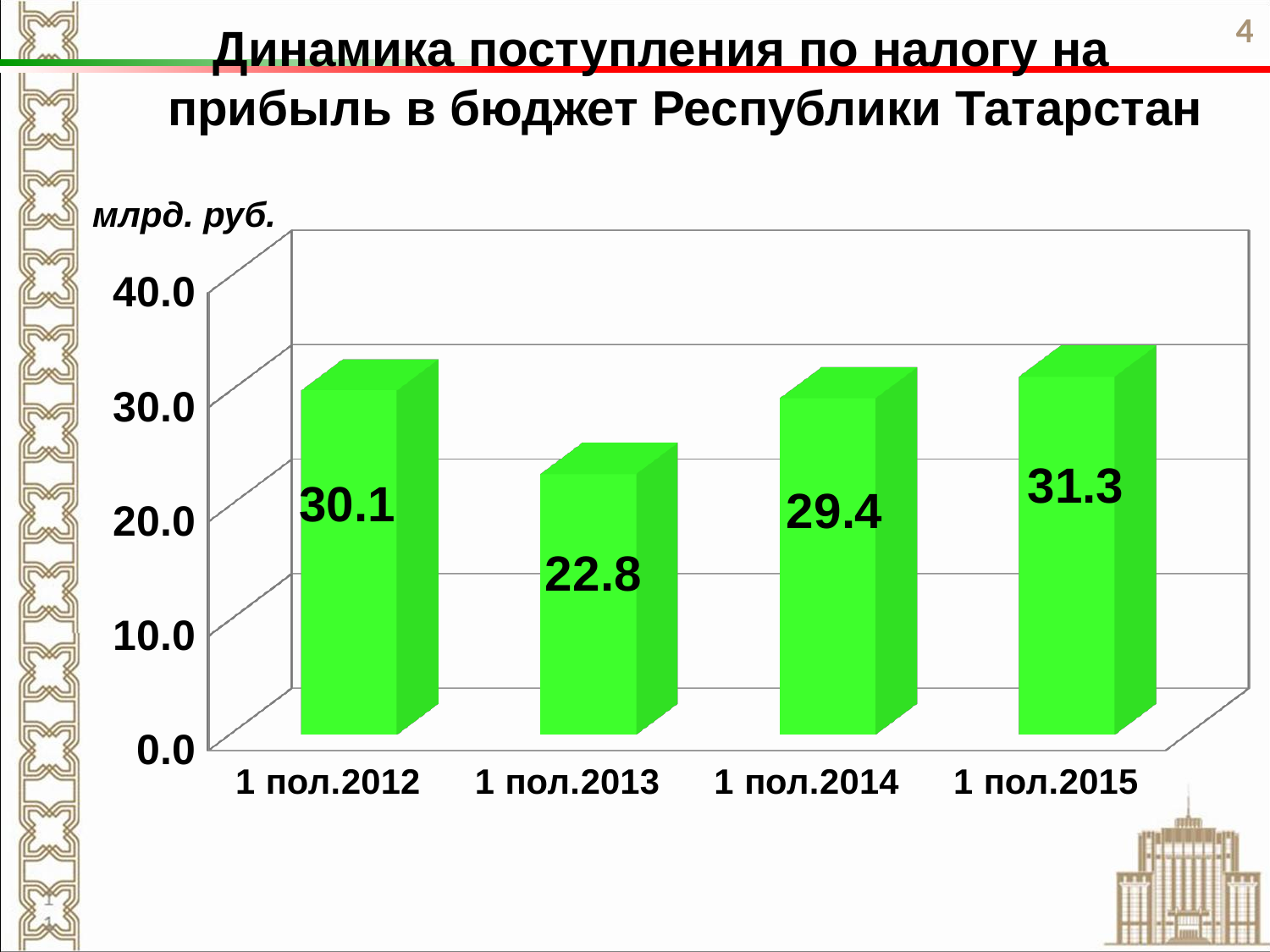
Which period has the highest value? 1 пол.2015 What is the value for 1 пол.2014? 29.4 Which is larger, the value for 1 пол.2012 or 1 пол.2014? 1 пол.2012 Which period has the lowest value? 1 пол.2013 What is the value for 1 пол.2015? 31.3 What kind of chart is shown on the slide? bar chart How many periods are shown on the chart? 4 Is the value for 1 пол.2013 greater or less than 30.0? less What is the difference between the values for 1 пол.2015 and 1 пол.2013? 8.5 What is the value for 1 пол.2013? 22.8 What is the value for 1 пол.2012? 30.1 What unit is indicated above the chart's vertical axis? млрд. руб.